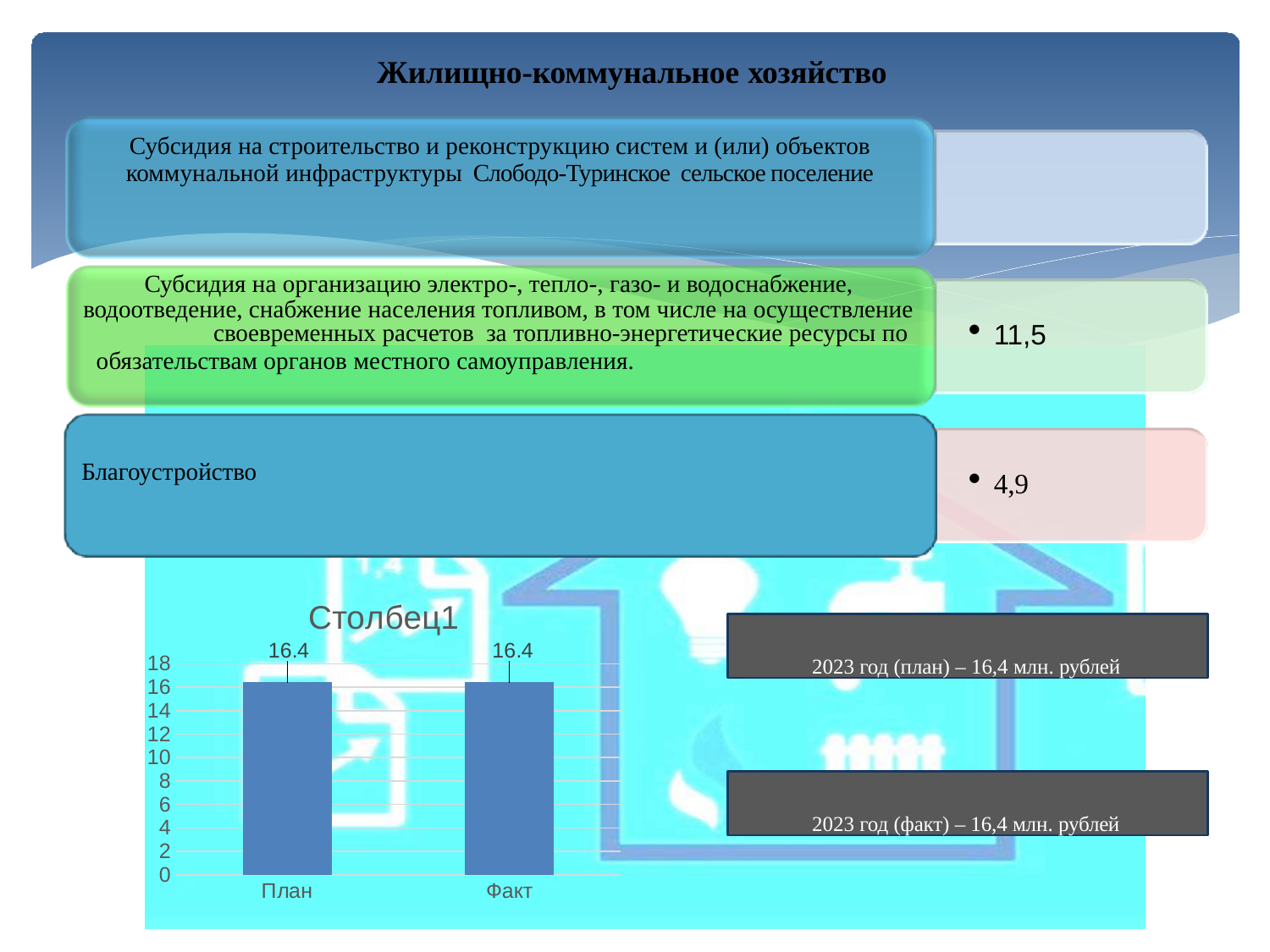
What is the difference between the План and Факт values in the chart? 0 What is the highest value shown on the chart's vertical axis? 18 Is the value for Факт greater or less than 18? less How many bars are plotted in the chart? 2 What is the value of the Факт bar in the chart? 16.4 What are the category labels on the x axis of the chart? План, Факт Is the value for План greater or less than 10? greater What is the title of the chart? Столбец1 What is the value of the План bar in the chart? 16.4 What type of chart is shown on the slide? bar chart